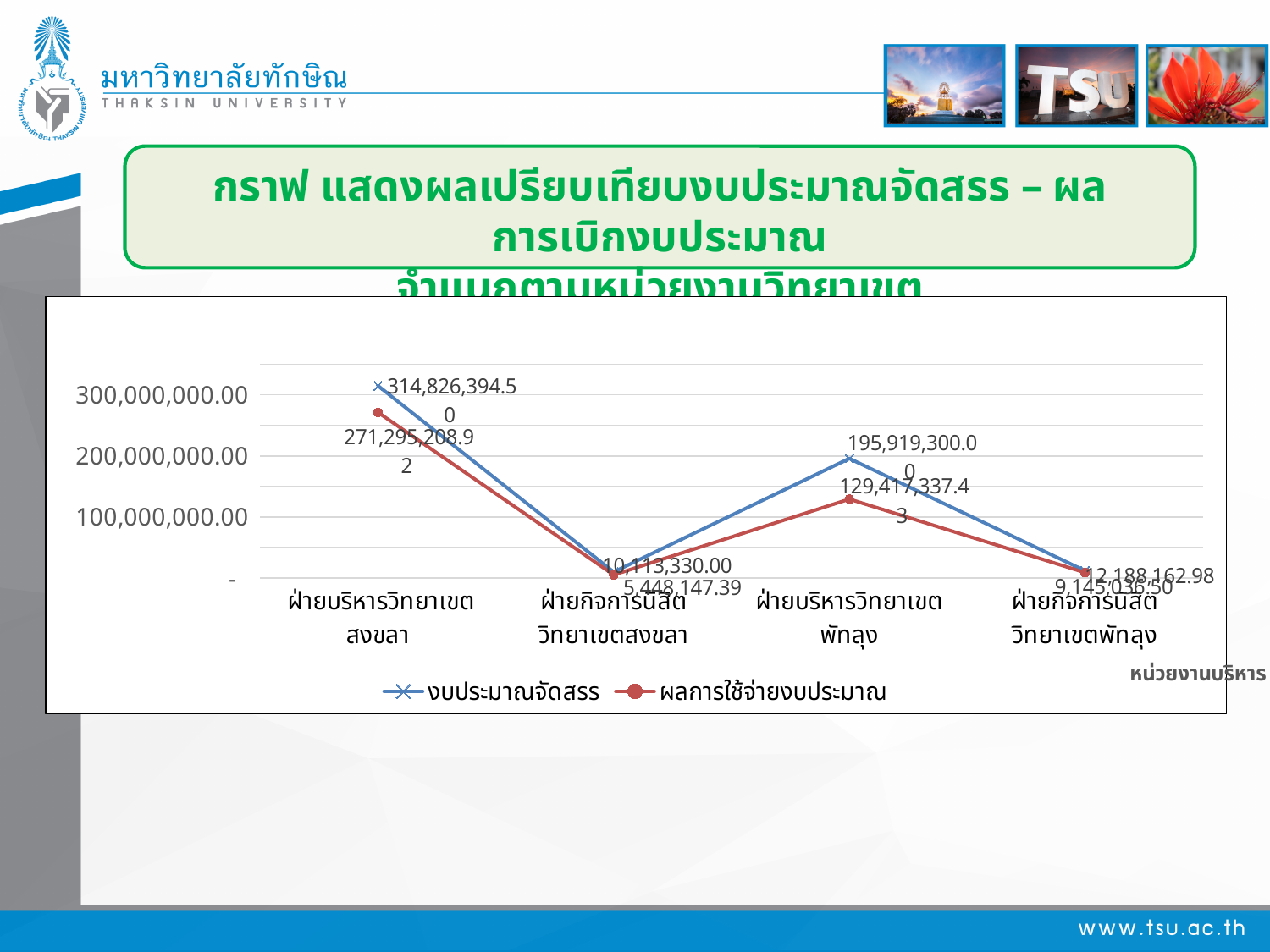
How many categories are shown on the x axis? 4 Which category has the lowest ผลการใช้จ่ายงบประมาณ value? ฝ่ายกิจการนิสิตวิทยาเขตสงขลา What is the งบประมาณจัดสรร value for ฝ่ายบริหารวิทยาเขตสงขลา? 314,826,394.50 What is the งบประมาณจัดสรร value for ฝ่ายบริหารวิทยาเขตพัทลุง? 195,919,300.00 What is the difference between งบประมาณจัดสรร and ผลการใช้จ่ายงบประมาณ for ฝ่ายบริหารวิทยาเขตพัทลุง? 66,501,962.57 Which is larger for ฝ่ายบริหารวิทยาเขตสงขลา: งบประมาณจัดสรร or ผลการใช้จ่ายงบประมาณ? งบประมาณจัดสรร Which series is drawn in red with circle markers? ผลการใช้จ่ายงบประมาณ What type of chart is shown on the slide? line chart What is the ผลการใช้จ่ายงบประมาณ value for ฝ่ายบริหารวิทยาเขตสงขลา? 271,295,208.92 How many series does the legend list? 2 Which category has the highest งบประมาณจัดสรร value? ฝ่ายบริหารวิทยาเขตสงขลา What is the ผลการใช้จ่ายงบประมาณ value for ฝ่ายกิจการนิสิตวิทยาเขตสงขลา? 5,448,147.39